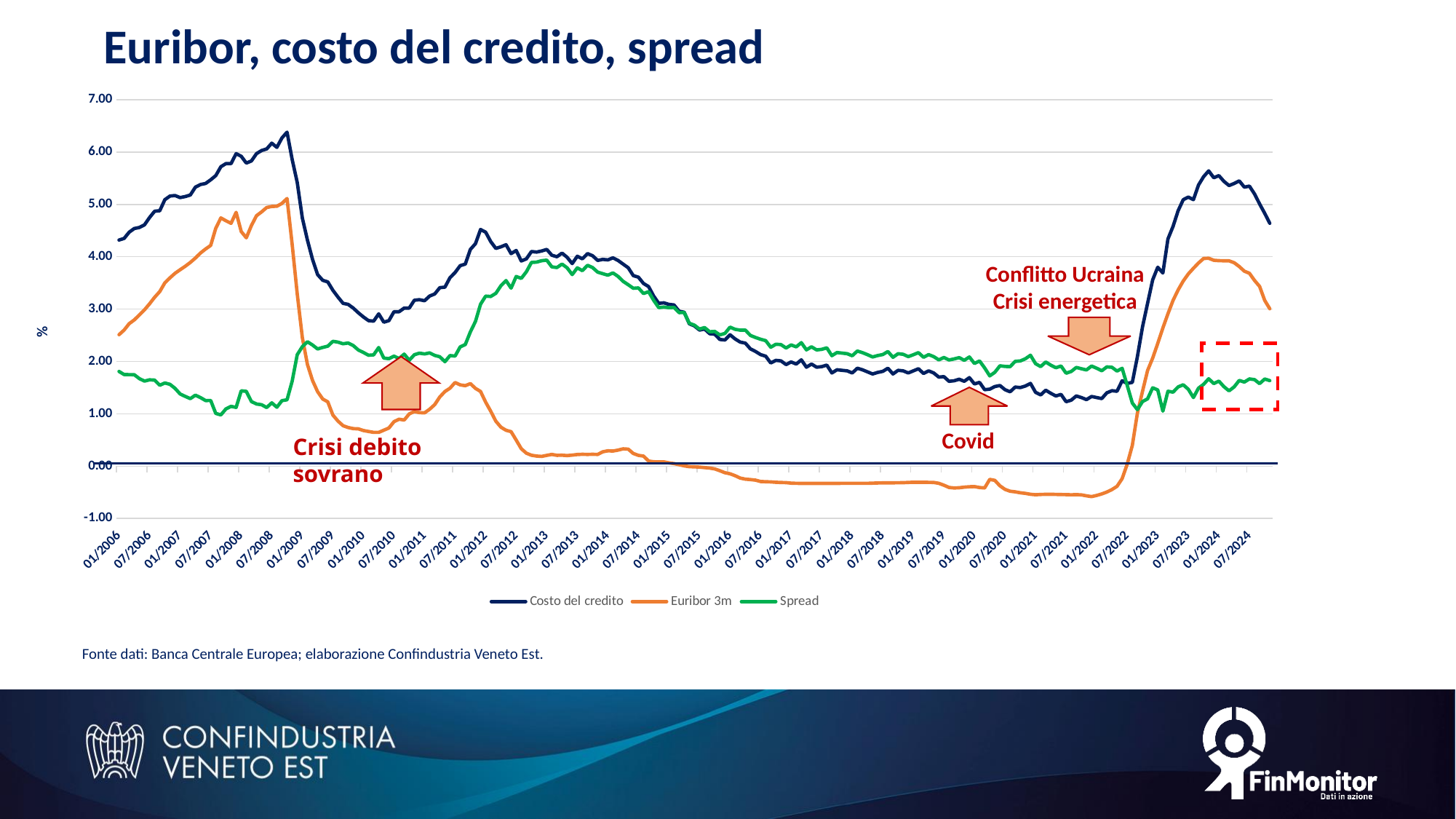
Is the value of Costo del credito at 01/2006 greater or less than 4.00? greater At 01/2021, which is larger: Spread or Euribor 3m? Spread Which series reaches the highest value anywhere on the chart? Costo del credito What is the title of the chart? Euribor, costo del credito, spread Is the value of Spread at 01/2013 greater or less than 3.00? greater What kind of chart is shown on the slide? line chart Is the value of Costo del credito at 01/2024 greater or less than 5.00? greater Which series is drawn in orange according to the legend? Euribor 3m How many series does the legend list? 3 At 01/2006, which is larger: Costo del credito or Euribor 3m? Costo del credito Does Euribor 3m rise or fall between 01/2022 and 07/2023? rise